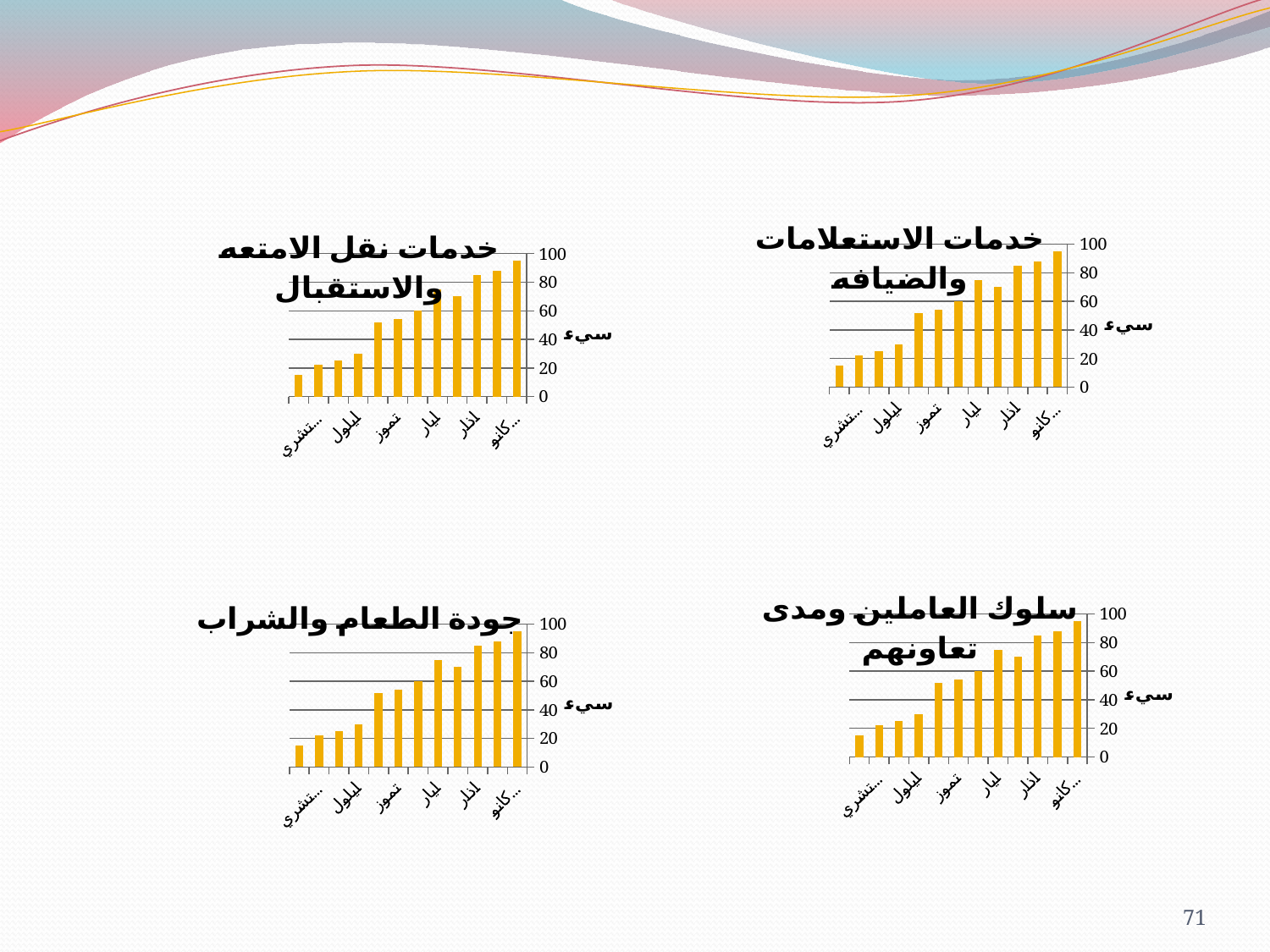
How many bars are plotted in the top-left chart titled خدمات نقل الامتعه والاستقبال? 12 In the bottom-left chart titled جودة الطعام والشراب, which is larger, the value for ايلول or the value for اذار? اذار In the top-right chart titled خدمات الاستعلامات والضيافه, is the value for تموز greater or less than 40? greater In the top-right chart titled خدمات الاستعلامات والضيافه, do the values generally rise or fall from left to right along the x axis? rise How many bar charts are shown on the slide? 4 In the bottom-left chart titled جودة الطعام والشراب, is the value for ايار greater or less than 80? less What kind of chart is the top-right chart titled خدمات الاستعلامات والضيافه? bar chart In the top-left chart titled خدمات نقل الامتعه والاستقبال, is the value for ايلول greater or less than 40? less In the top-left chart titled خدمات نقل الامتعه والاستقبال, do the values generally rise or fall from left to right along the x axis? rise